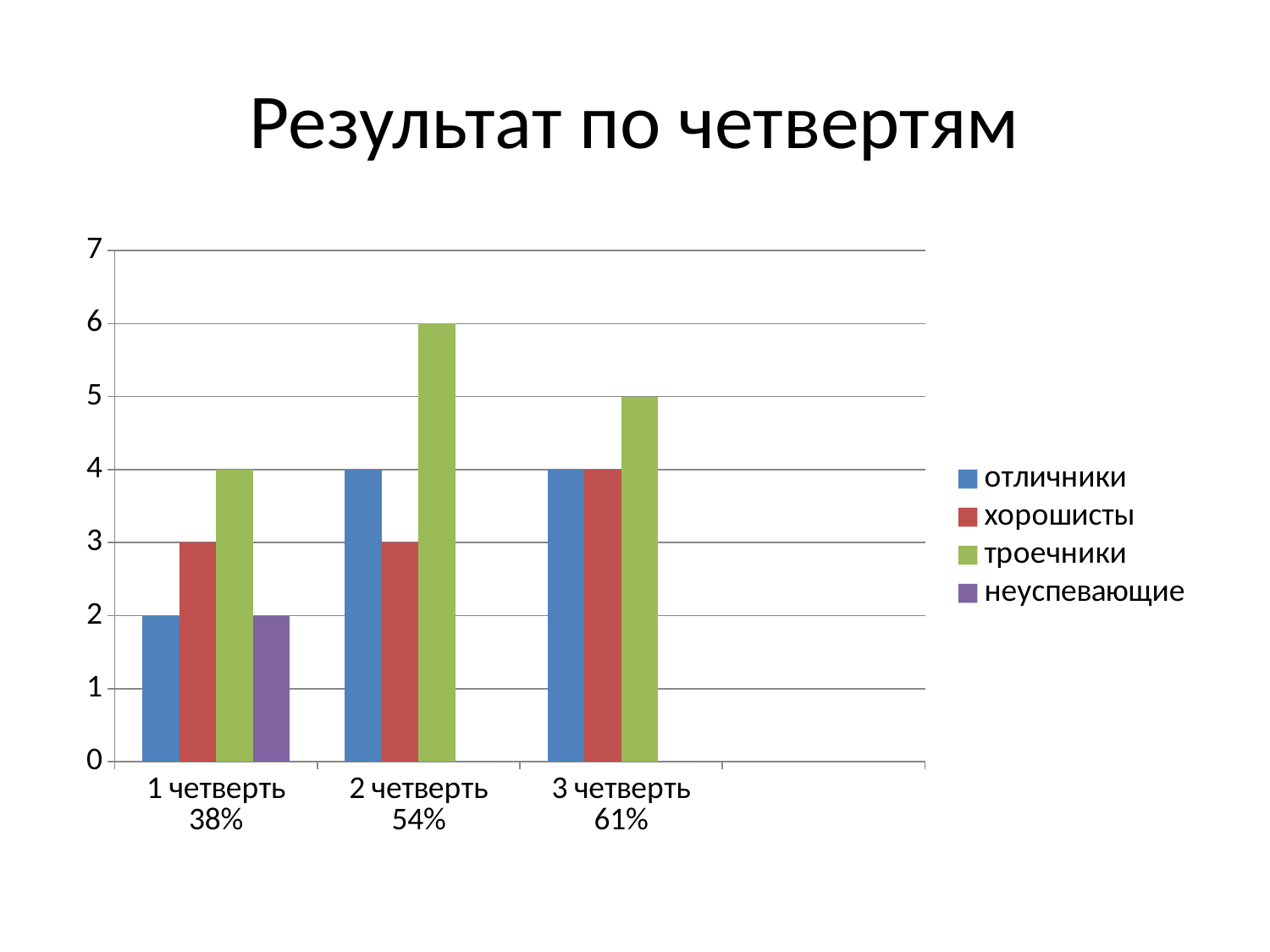
What is the value for неуспевающие in 1 четверть 38%? 2 What is the title of the slide? Результат по четвертям What is the value for хорошисты in 3 четверть 61%? 4 How many series does the legend list? 4 How many quarters (categories) are shown on the x axis? 3 Which is larger in 1 четверть 38%: хорошисты or отличники? хорошисты What is the value for троечники in 2 четверть 54%? 6 What kind of chart is this? bar chart In which quarter is the value for отличники lowest? 1 четверть 38% What is the value for отличники in 1 четверть 38%? 2 In which quarter is the value for троечники highest? 2 четверть 54% What is the difference between троечники and отличники in 2 четверть 54%? 2